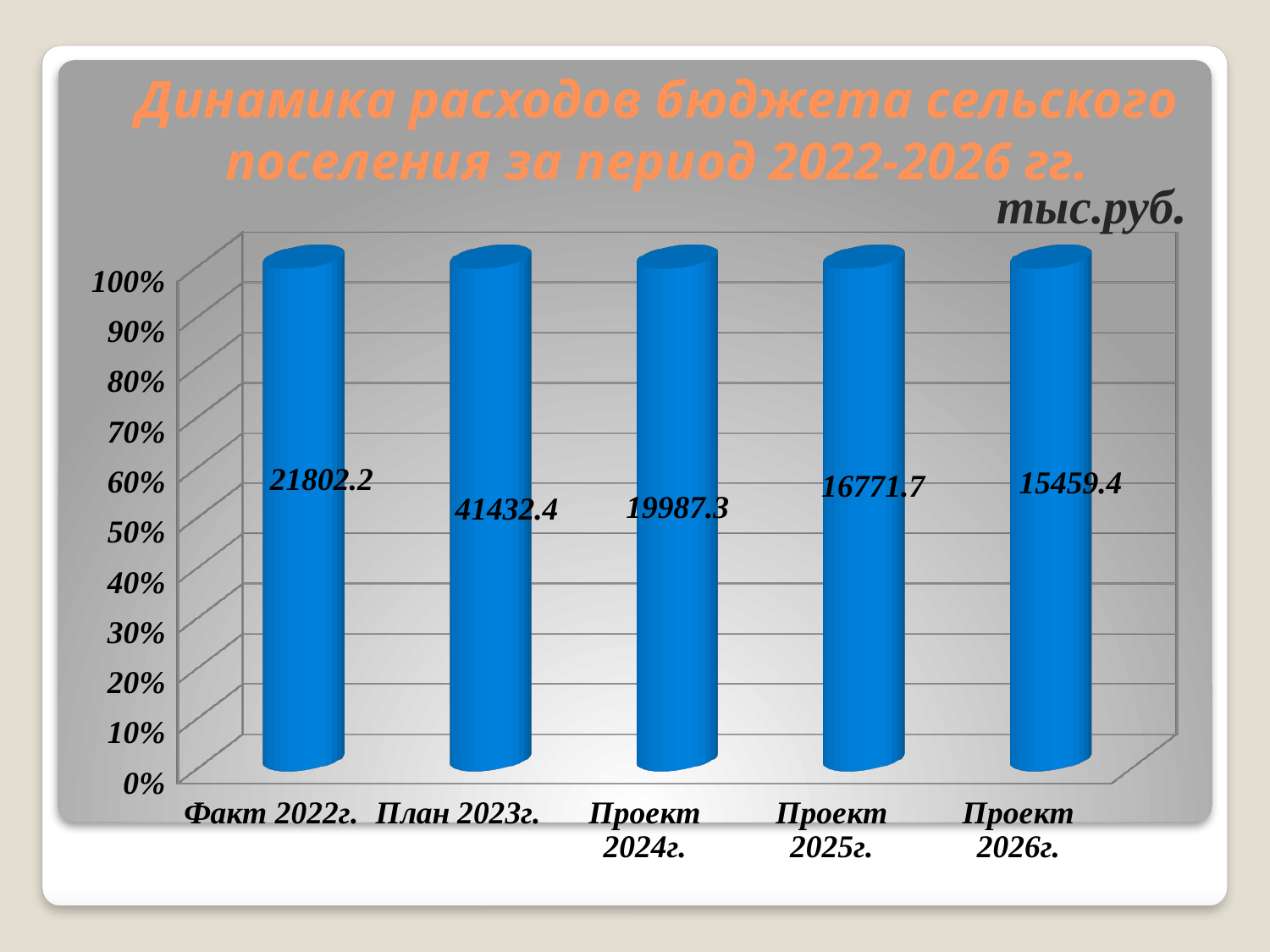
What is the difference between the labelled values for Проект 2025г. and Проект 2026г.? 1312.3 What is the value labelled on the bar for План 2023г.? 41432.4 Which category has the lowest labelled value? Проект 2026г. What kind of chart is shown on the slide? Bar chart What is the value labelled on the bar for Факт 2022г.? 21802.2 How many categories are shown on the x axis? 5 What is the value labelled on the bar for Проект 2024г.? 19987.3 Do the labelled values rise or fall from План 2023г. to Проект 2026г.? Fall What is the difference between the labelled values for План 2023г. and Факт 2022г.? 19630.2 Which category has the highest labelled value? План 2023г. What is the value labelled on the bar for Проект 2026г.? 15459.4 Which has the larger labelled value, Проект 2024г. or Проект 2025г.? Проект 2024г.